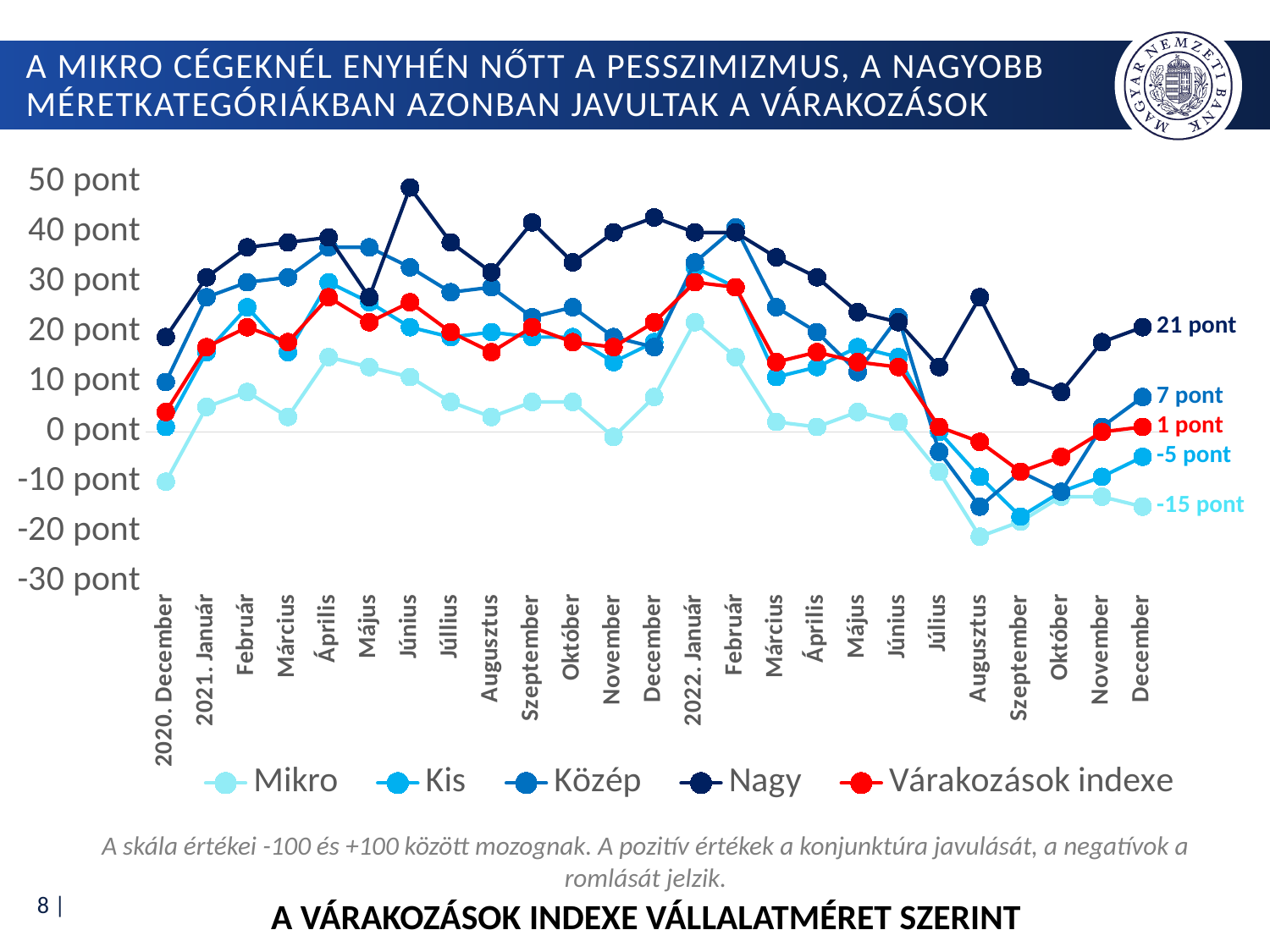
What is the difference between the Nagy and Közép values in December 2022? 14 pont Which series has the lowest value in December 2022? Mikro What is the value of the Mikro series in December 2022? -15 pont What is the value of the Várakozások indexe series in December 2022? 1 pont What kind of chart is shown on the slide? line chart What is the value of the Kis series in December 2022? -5 pont How many months are shown on the x axis? 25 How many series does the legend list? 5 Is the value for Nagy in 2021 Június greater or less than 40 pont? greater Does the Mikro series rise or fall from 2022 Augusztus to 2022 December? rise What is the value of the Nagy series in December 2022? 21 pont Which series has the highest value in December 2022? Nagy